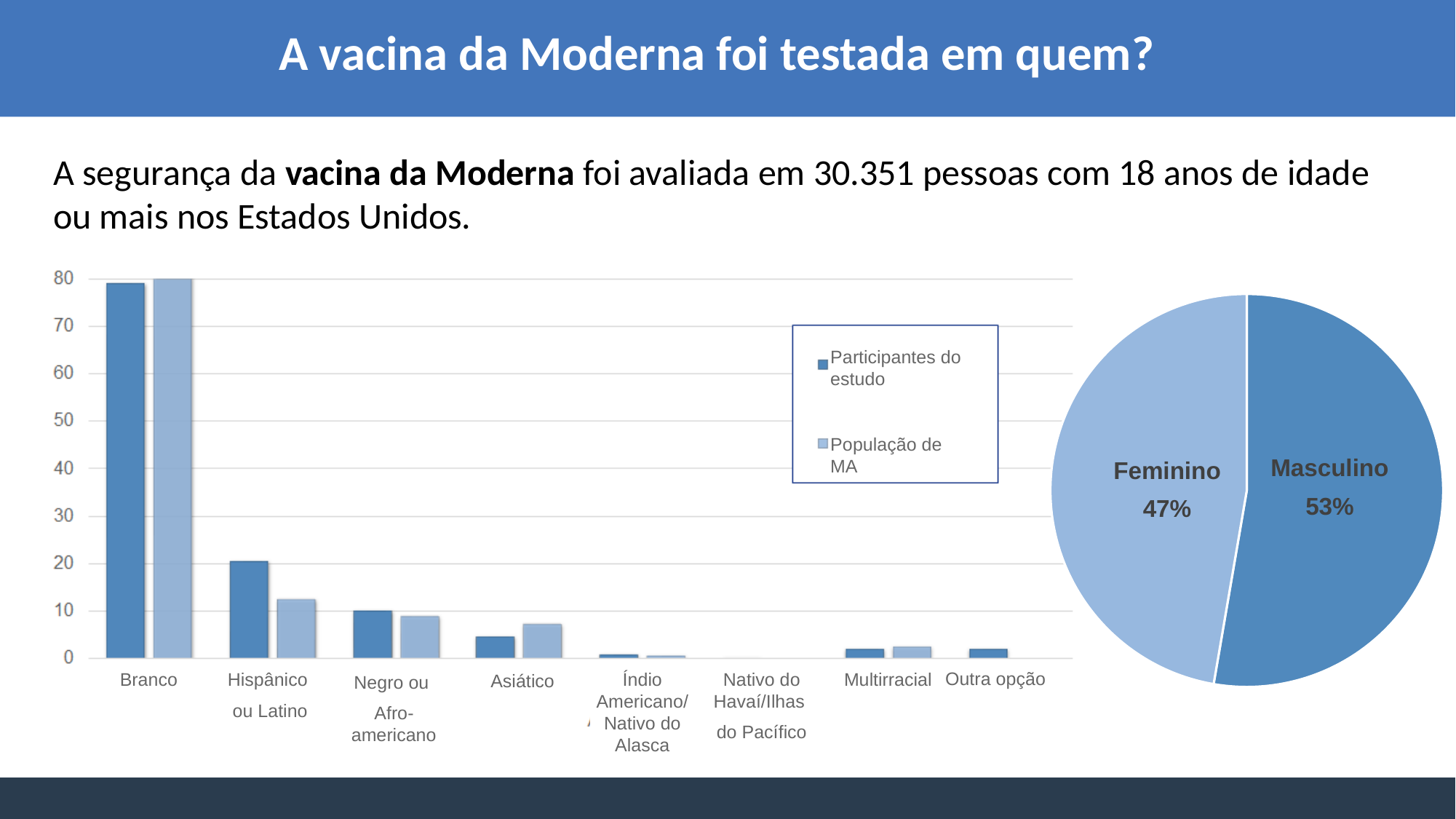
On the bar chart on the left, how many categories are shown on the x axis? 8 On the bar chart on the left, how many series does the legend list? 2 On the bar chart on the left, for Hispânico ou Latino, which series has the larger value, Participantes do estudo or População de MA? Participantes do estudo On the bar chart on the left, which category has the highest value for Participantes do estudo? Branco On the bar chart on the left, is the value for Branco in the Participantes do estudo series greater or less than 70? greater On the pie chart on the right, which slice is larger, Feminino or Masculino? Masculino On the bar chart on the left, is the value for Asiático in the Participantes do estudo series greater or less than 10? less On the pie chart on the right, what percentage is shown for Feminino? 47% On the pie chart on the right, what percentage is shown for Masculino? 53% What type of chart is shown on the left of the slide? Bar chart On the pie chart on the right, how many slices are there? 2 On the pie chart on the right, what is the difference in percentage points between Masculino and Feminino? 6